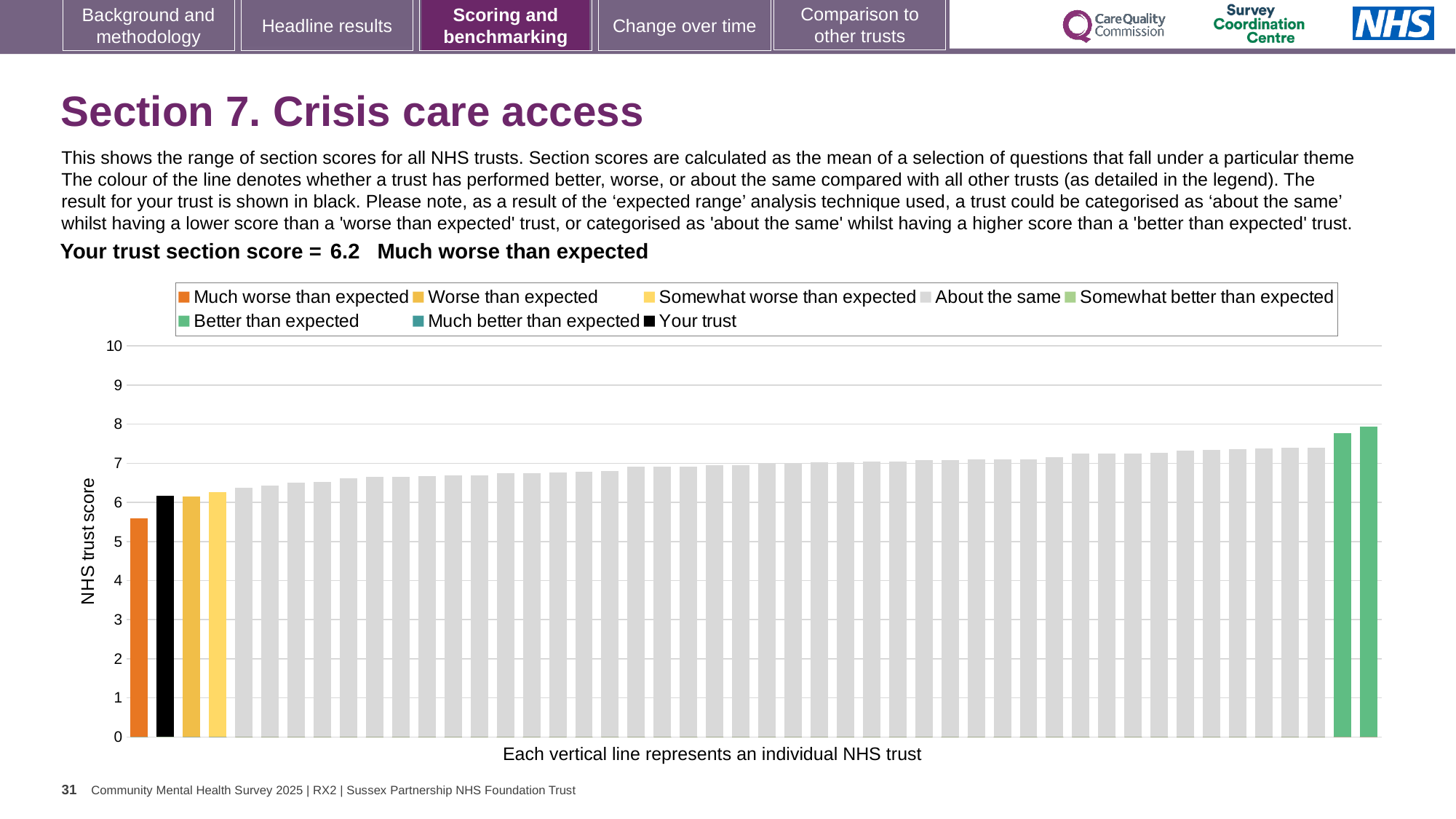
Is the value for the 'Much worse than expected' (orange) bar greater or less than 6? less What kind of chart is shown on the slide? Bar chart Is the value for the 'Your trust' (black) bar greater or less than 6? greater Which is larger, the 'Your trust' bar or the 'Much worse than expected' bar? Your trust What is the label on the vertical axis of the chart? NHS trust score How many bars on the chart are coloured green ('Better than expected')? 2 What is the section score for your trust shown on the slide? 6.2 Which category of bar has the lowest score on the chart? Much worse than expected Which category of bar has the highest score on the chart? Better than expected How many entries does the chart legend list? 8 Do the bar values rise or fall from left to right along the x axis? Rise Is the value for the tallest bar on the chart greater or less than 7? greater